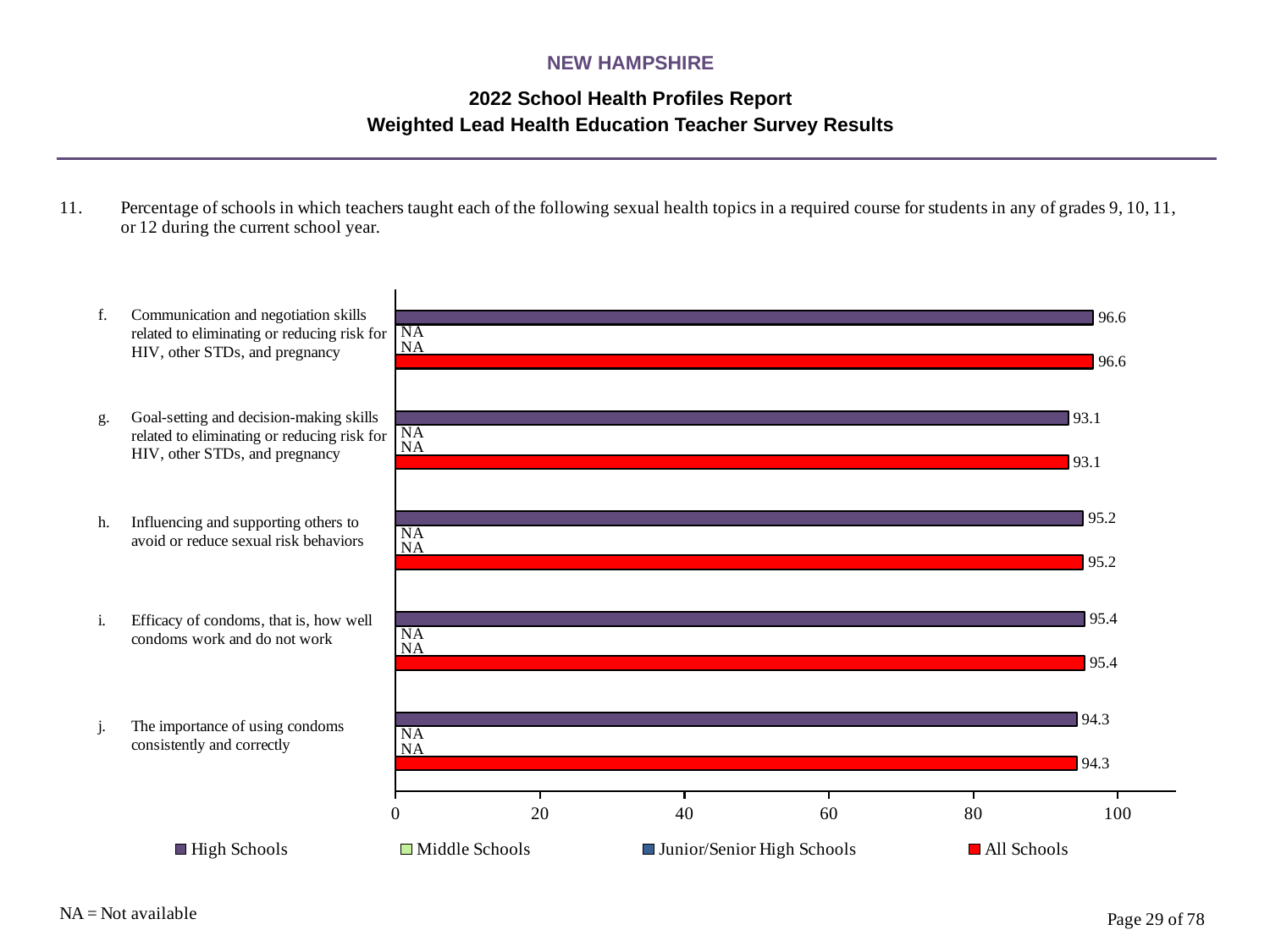
What is the High Schools value for 'Efficacy of condoms, that is, how well condoms work and do not work'? 95.4 What is the difference between the High Schools values for 'Communication and negotiation skills' and 'Goal-setting and decision-making skills'? 3.5 Is the All Schools value for 'Efficacy of condoms' greater or less than 80? greater What kind of chart is shown on the slide? bar chart Which is larger: the High Schools value for 'Influencing and supporting others to avoid or reduce sexual risk behaviors' or for 'The importance of using condoms consistently and correctly'? Influencing and supporting others to avoid or reduce sexual risk behaviors Which topic has the highest High Schools value? Communication and negotiation skills related to eliminating or reducing risk for HIV, other STDs, and pregnancy How many series does the legend list? 4 What is the All Schools value for 'The importance of using condoms consistently and correctly'? 94.3 How many topics are plotted on the chart? 5 What is the High Schools value for 'Communication and negotiation skills related to eliminating or reducing risk for HIV, other STDs, and pregnancy'? 96.6 Which topic has the lowest All Schools value? Goal-setting and decision-making skills related to eliminating or reducing risk for HIV, other STDs, and pregnancy What is the All Schools value for 'Goal-setting and decision-making skills related to eliminating or reducing risk for HIV, other STDs, and pregnancy'? 93.1